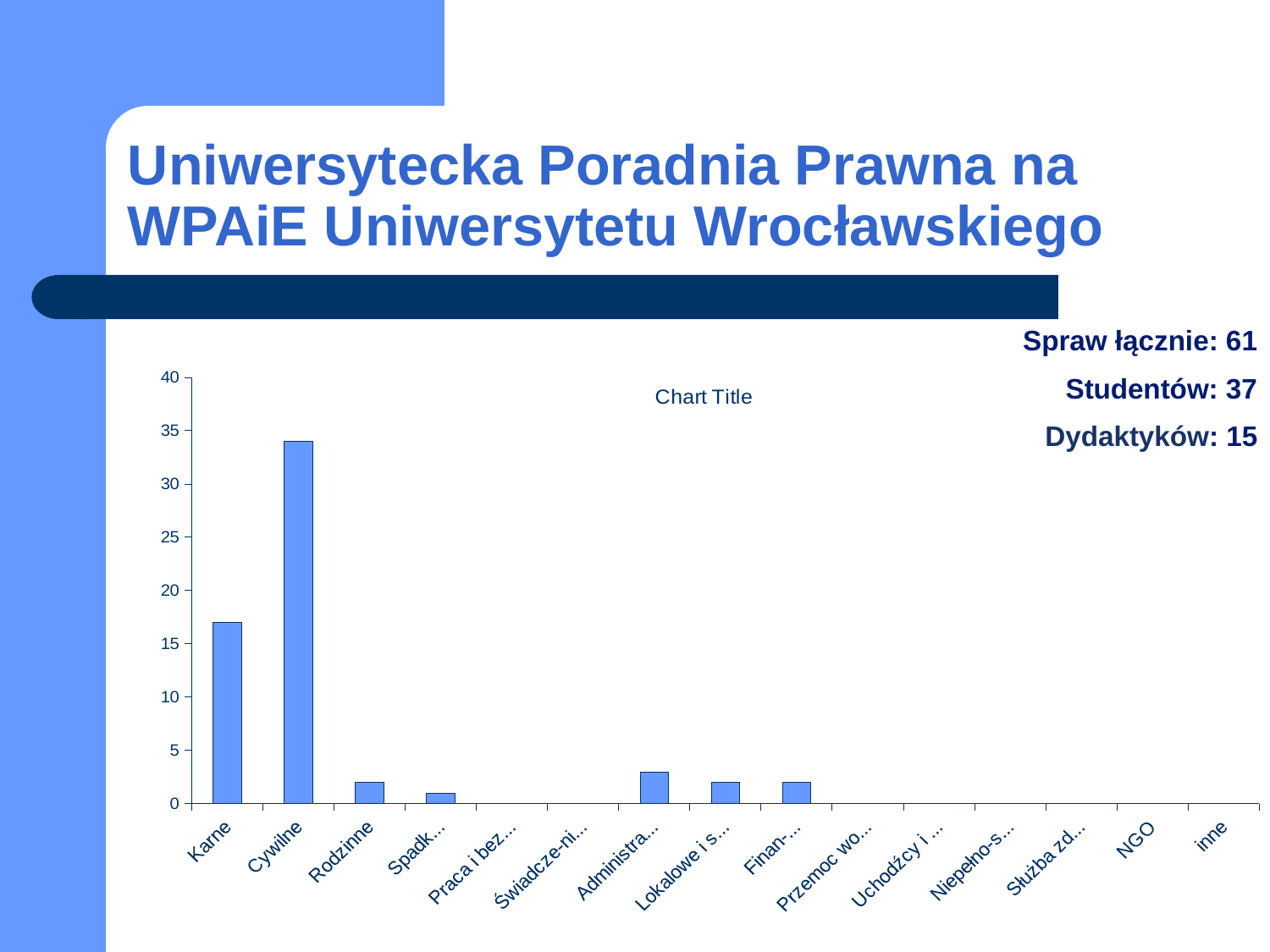
Is the value for Cywilne greater or less than 30? greater Is the value for Karne greater or less than 15? greater Which is larger, the value for Karne or the value for Cywilne? Cywilne Which category has the highest bar in the chart? Cywilne Is the value for Karne greater or less than 20? less How many categories are shown on the x axis of the chart? 15 Which is larger, the value for Rodzinne or the value for Spadk...? Rodzinne What is the title shown on the chart? Chart Title What is the highest value shown on the chart's vertical axis? 40 What kind of chart is shown on the slide? bar chart